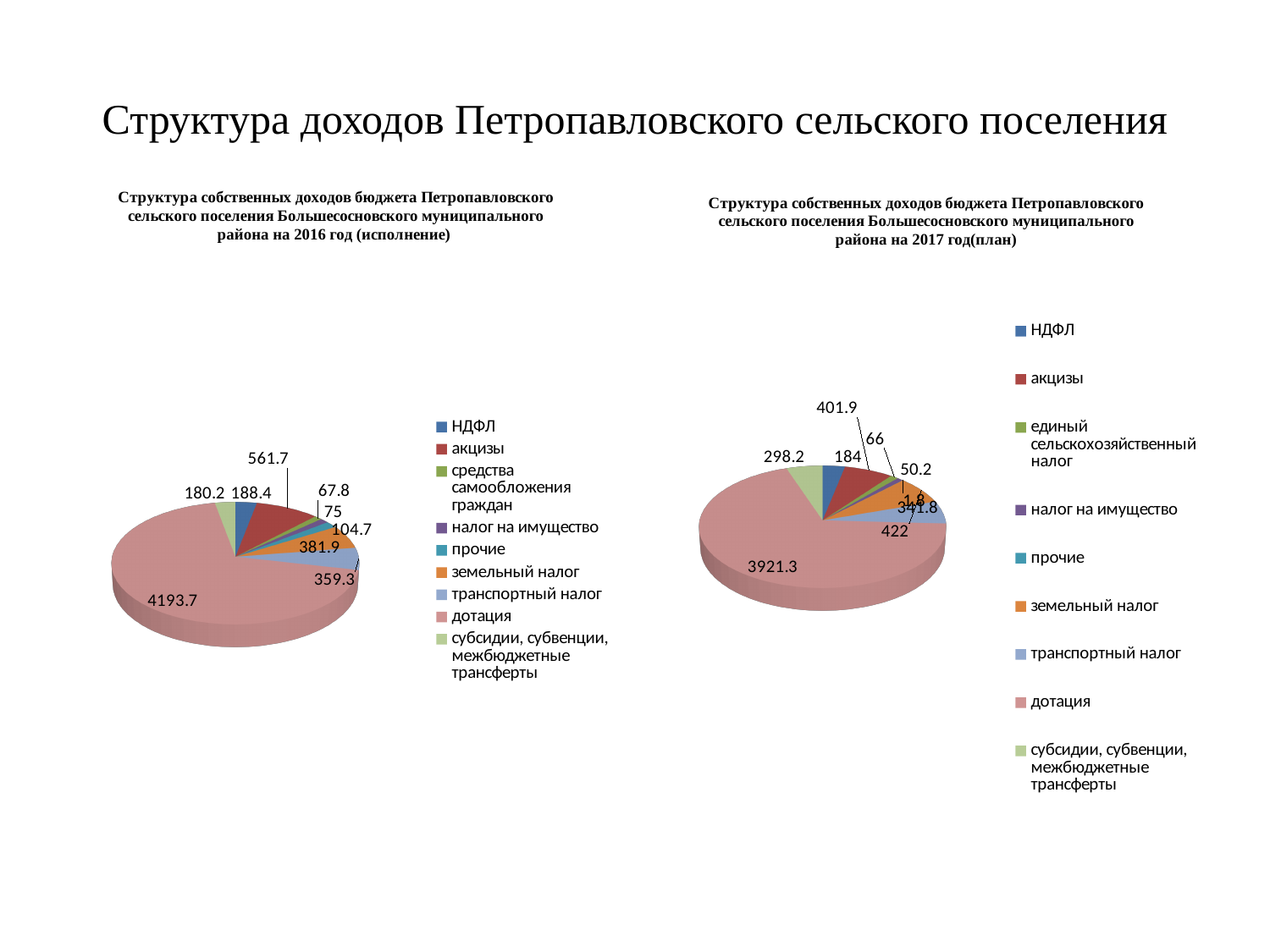
Which is larger in the left chart (2016 исполнение): the slice labelled 381.9 or the slice labelled 359.3? 381.9 In the left chart (2016 исполнение), which category has the largest slice? дотация How many entries does the legend of the right chart (2017 план) list? 9 In the left chart (2016 исполнение), what is the value of the largest slice, дотация? 4193.7 What is the difference between the дотация value in the 2016 chart (4193.7) and in the 2017 chart (3921.3)? 272.4 In the right chart (2017 план), what is the smallest labelled value? 1.8 In the right chart (2017 план), what is the value labelled for the акцизы slice? 401.9 In the right chart (2017 план), which category has the largest slice? дотация What type of chart is used on the left side of the slide for the 2016 budget structure? pie chart In the right chart (2017 план), what is the value of the дотация slice? 3921.3 Which legend entry appears in the right chart (2017 план) but not in the left chart (2016 исполнение)? единый сельскохозяйственный налог In the left chart (2016 исполнение), what is the value labelled for the акцизы slice? 561.7